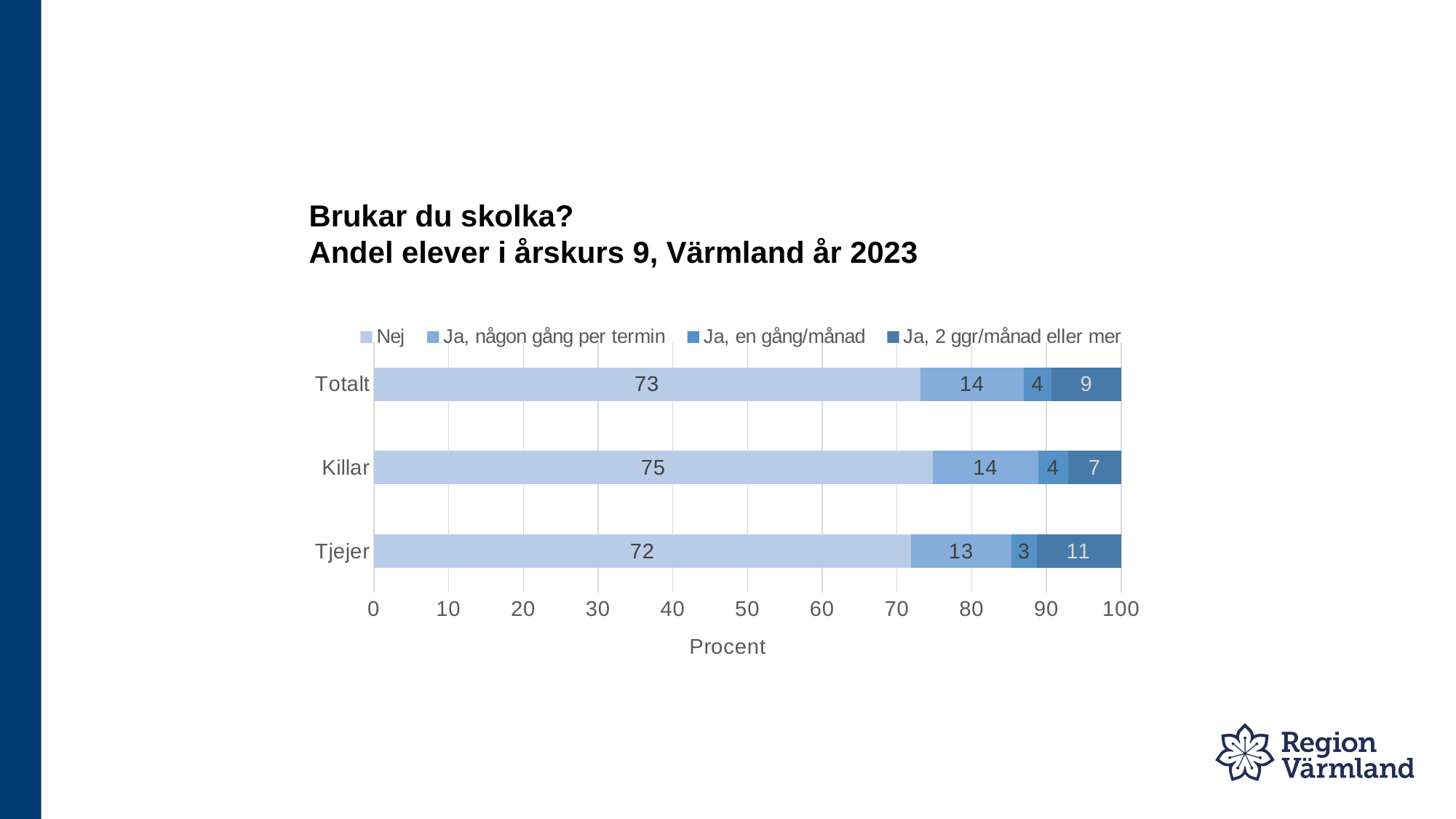
What is the total of the Killar bar? 100 What is the difference between the "Ja, 2 ggr/månad eller mer" values for Tjejer and Killar? 4 What kind of chart is shown on the slide? Stacked bar chart What is the label of the x axis? Procent How many categories are shown on the y axis? 3 What is the value for "Nej" in the Totalt bar? 73 What is the value for "Ja, 2 ggr/månad eller mer" in the Tjejer bar? 11 Which is larger: the "Nej" value for Tjejer or for Killar? Killar What is the value for "Ja, någon gång per termin" in the Killar bar? 14 How many series does the legend list? 4 Which category has the highest value for "Nej"? Killar Which category has the lowest value for "Ja, 2 ggr/månad eller mer"? Killar